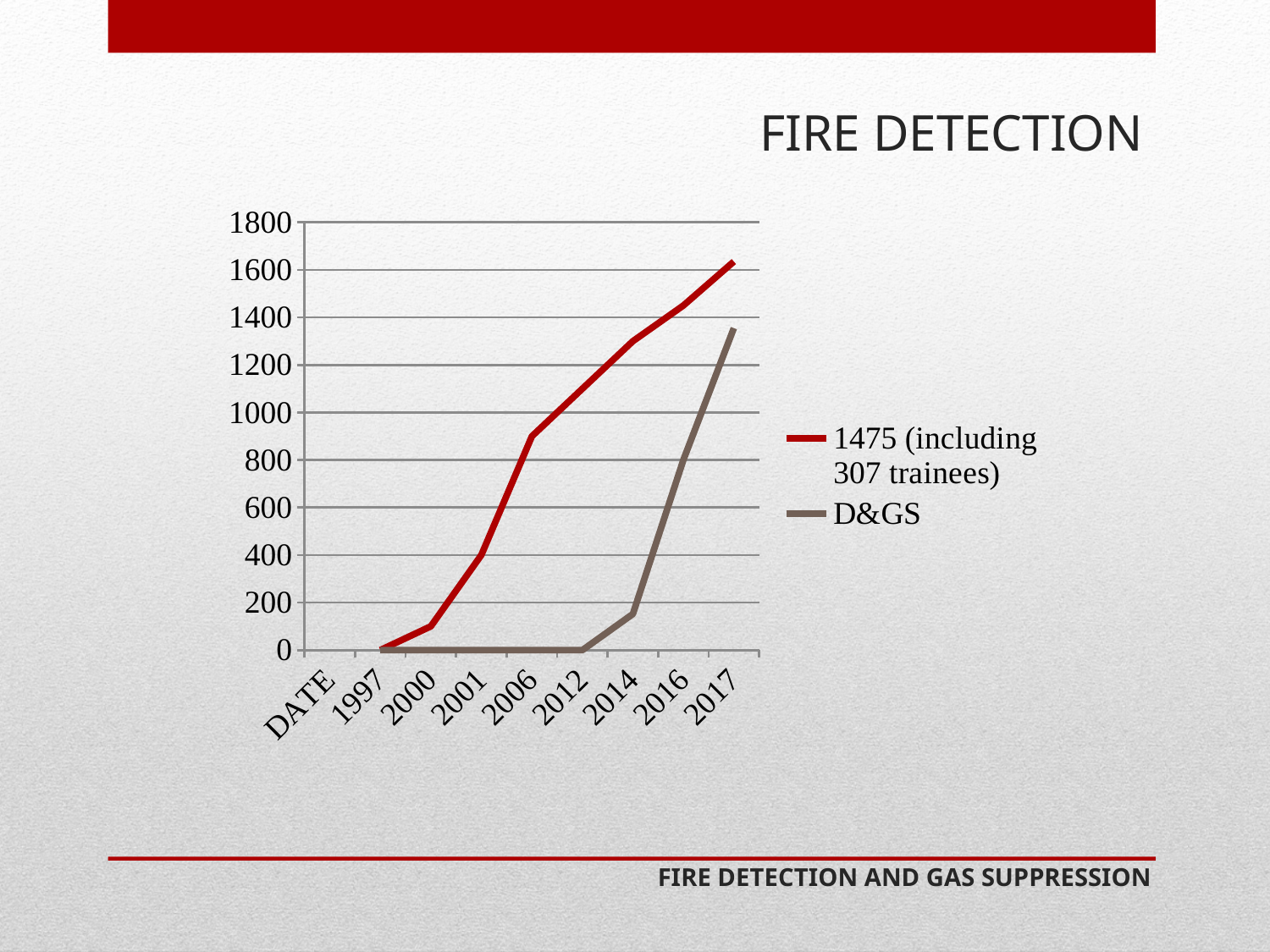
Is the value for the 1475 (including 307 trainees) series in 2017 greater or less than 1400? greater What kind of chart is shown on the slide? line chart Do the values of the 1475 (including 307 trainees) series rise or fall from 1997 to 2017? rise In which year does the D&GS series reach its highest value? 2017 Is the value for the 1475 (including 307 trainees) series in 2006 greater or less than 600? greater Do the values of the D&GS series rise or fall from 2012 to 2017? rise In 2016, which series has the larger value, 1475 (including 307 trainees) or D&GS? 1475 (including 307 trainees) Is the value for the D&GS series in 2014 greater or less than 400? less How many series does the legend list? 2 What is the title of the slide containing the chart? FIRE DETECTION How many categories are shown along the x axis? 9 Which series is drawn in red? 1475 (including 307 trainees)